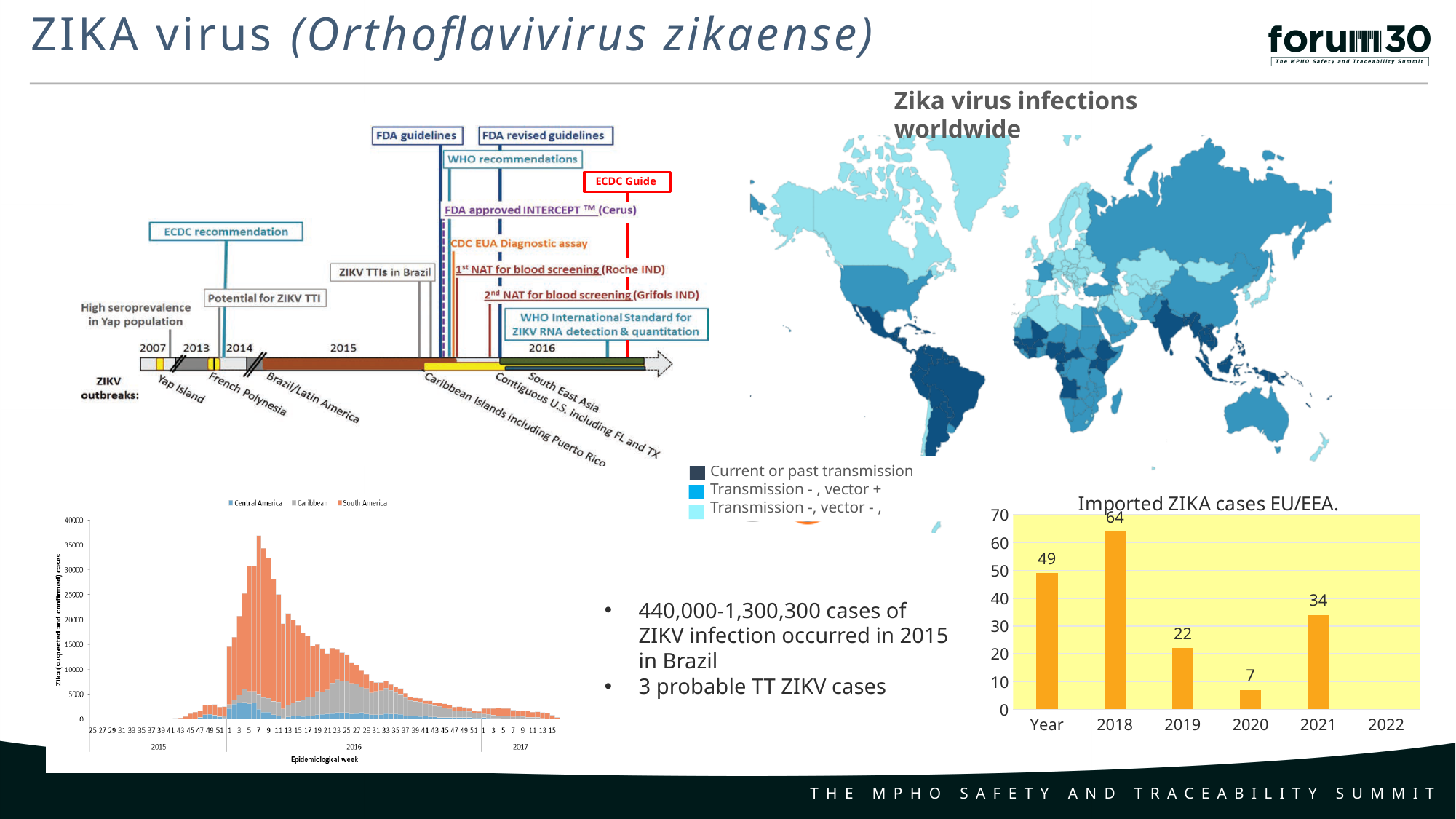
In the 'Imported ZIKA cases EU/EEA.' chart, what is the value for 2020? 7 In the 'Imported ZIKA cases EU/EEA.' chart, do the values rise or fall from 2018 to 2020? fall What kind of chart is 'Imported ZIKA cases EU/EEA.'? bar chart In the 'Imported ZIKA cases EU/EEA.' chart, which is larger, the value for 2019 or the value for 2021? 2021 In the 'Imported ZIKA cases EU/EEA.' chart, how many bars are plotted? 5 In the 'Imported ZIKA cases EU/EEA.' chart, which year has the highest number of cases? 2018 In the 'Imported ZIKA cases EU/EEA.' chart, what is the difference between the values for 2018 and 2019? 42 In the bottom-left chart of Zika cases by epidemiological week, how many series does the legend list? 3 In the bottom-left chart of Zika cases by epidemiological week, which series contributes the most cases at the 2016 peak? South America In the 'Imported ZIKA cases EU/EEA.' chart, what is the value for 2018? 64 In the 'Imported ZIKA cases EU/EEA.' chart, what is the value for 2021? 34 In the 'Imported ZIKA cases EU/EEA.' chart, which year has the lowest number of cases among the plotted bars? 2020